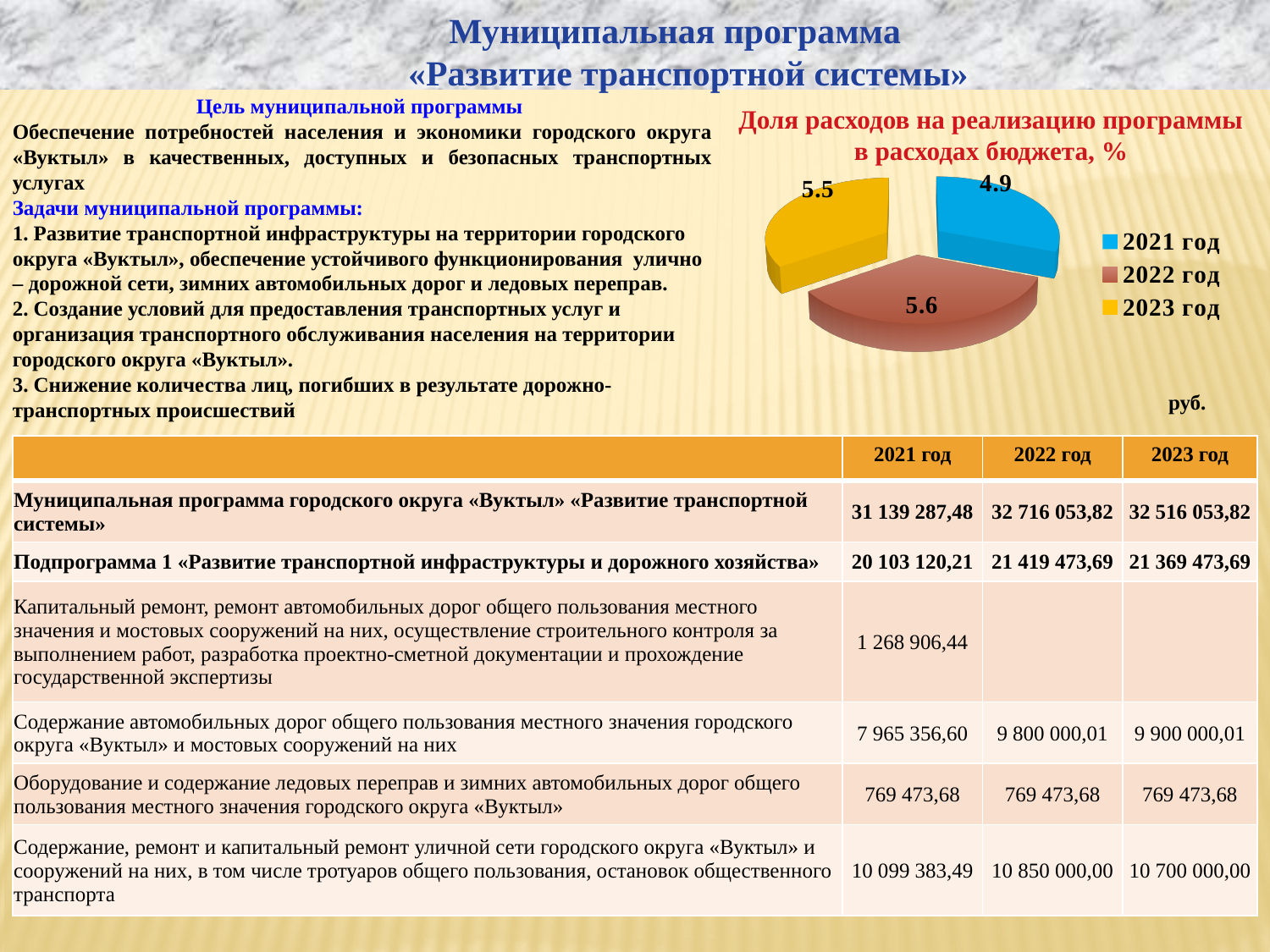
What is the difference between the values for 2022 год and 2021 год in the pie chart? 0.7 What type of chart is shown on the slide? Pie chart What colour is the slice for 2023 год in the pie chart? Yellow How many slices does the pie chart have? 3 What is the difference between the values for 2023 год and 2021 год in the pie chart? 0.6 Which is larger in the pie chart, the value for 2021 год or the value for 2023 год? 2023 год How many entries does the legend of the pie chart list? 3 Which year has the largest slice in the pie chart? 2022 год Which year has the smallest slice in the pie chart? 2021 год What is the value shown for 2022 год in the pie chart? 5.6 What is the value shown for 2023 год in the pie chart? 5.5 What is the value shown for 2021 год in the pie chart? 4.9